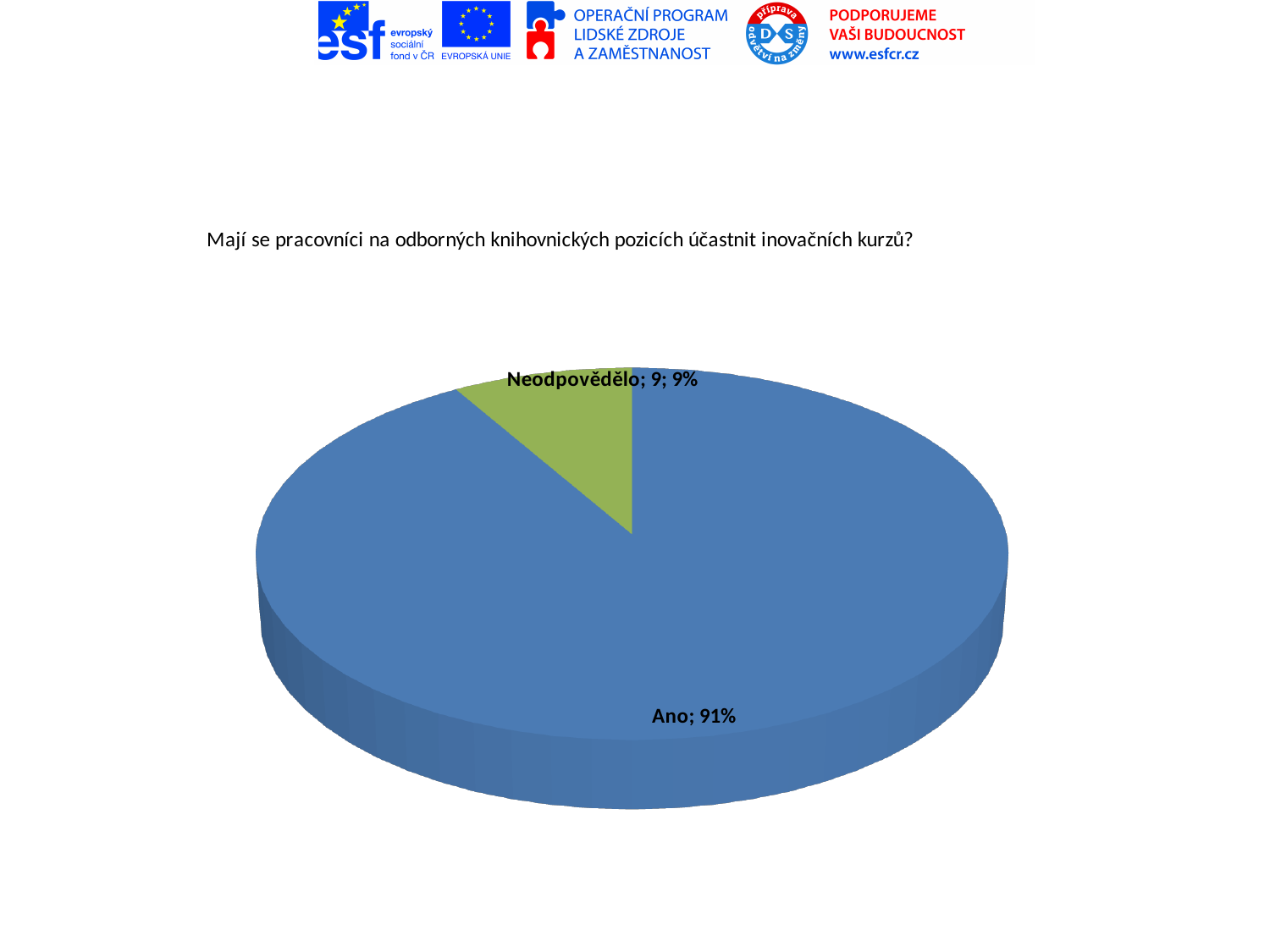
How many slices does the pie chart have? 2 Which is larger, the "Ano" slice or the "Neodpovědělo" slice? Ano What count is printed for the "Neodpovědělo" slice? 9 What colour is the "Neodpovědělo" slice? green What kind of chart is shown on the slide? pie chart What share of the pie does the "Neodpovědělo" slice represent? 9% Which slice of the pie is the smallest? Neodpovědělo Which slice of the pie is the largest? Ano What question is the chart titled with? Mají se pracovníci na odborných knihovnických pozicích účastnit inovačních kurzů? What share of the pie does the "Ano" slice represent? 91% What is the difference in percentage points between the "Ano" and "Neodpovědělo" slices? 82